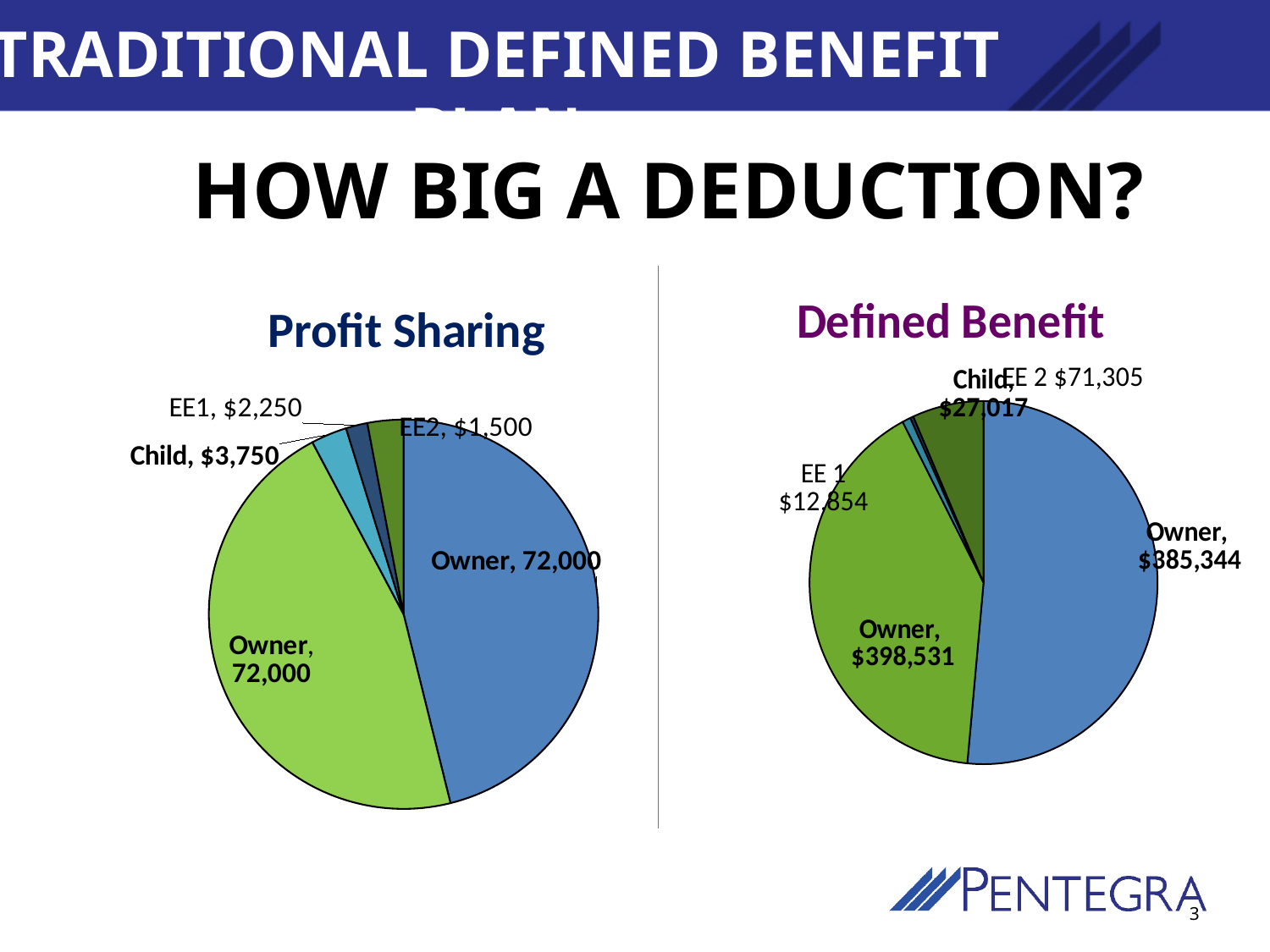
In the Profit Sharing chart, what is the value for EE1? $2,250 In the Defined Benefit chart, what is the value for EE 1? $12,854 In the Profit Sharing chart, what is the value for EE2? $1,500 What kind of chart is the Profit Sharing chart? Pie chart In the Defined Benefit chart, what is the value for EE 2? $71,305 What is the title of the chart on the left side of the slide? Profit Sharing How many slices does the Profit Sharing pie chart have? 5 In the Profit Sharing chart, what is the difference between the Child value and the EE1 value? $1,500 In the Profit Sharing chart, what is the value for Child? $3,750 In the Defined Benefit chart, what is the difference between the two Owner slices ($398,531 and $385,344)? $13,187 In the Defined Benefit chart, what is the value for Child? $27,017